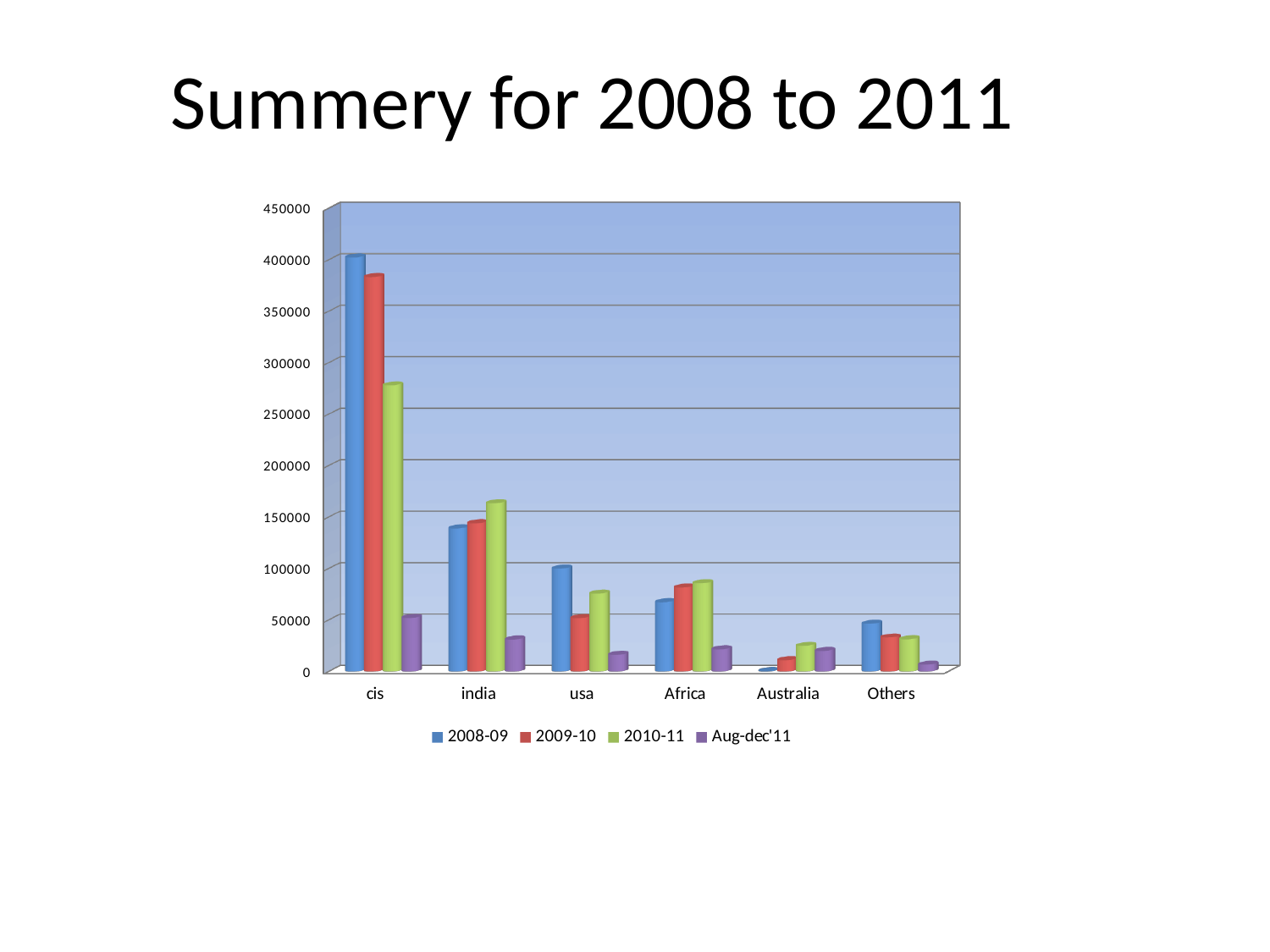
Which is larger for the 2008-09 series: cis or india? cis Which category has the highest value for the 2008-09 series? cis How many categories are shown on the x axis of the chart? 6 How many series does the chart's legend list? 4 Is the 2008-09 value for cis greater or less than 350000? greater What is the title of the slide containing the chart? Summery for 2008 to 2011 What kind of chart is shown on the slide? bar chart Is the 2010-11 value for cis greater or less than 300000? less Is the 2010-11 value for Australia greater or less than 50000? less Which category has the lowest value for the 2008-09 series? Australia For cis, do the values rise or fall from 2008-09 through Aug-dec'11? fall